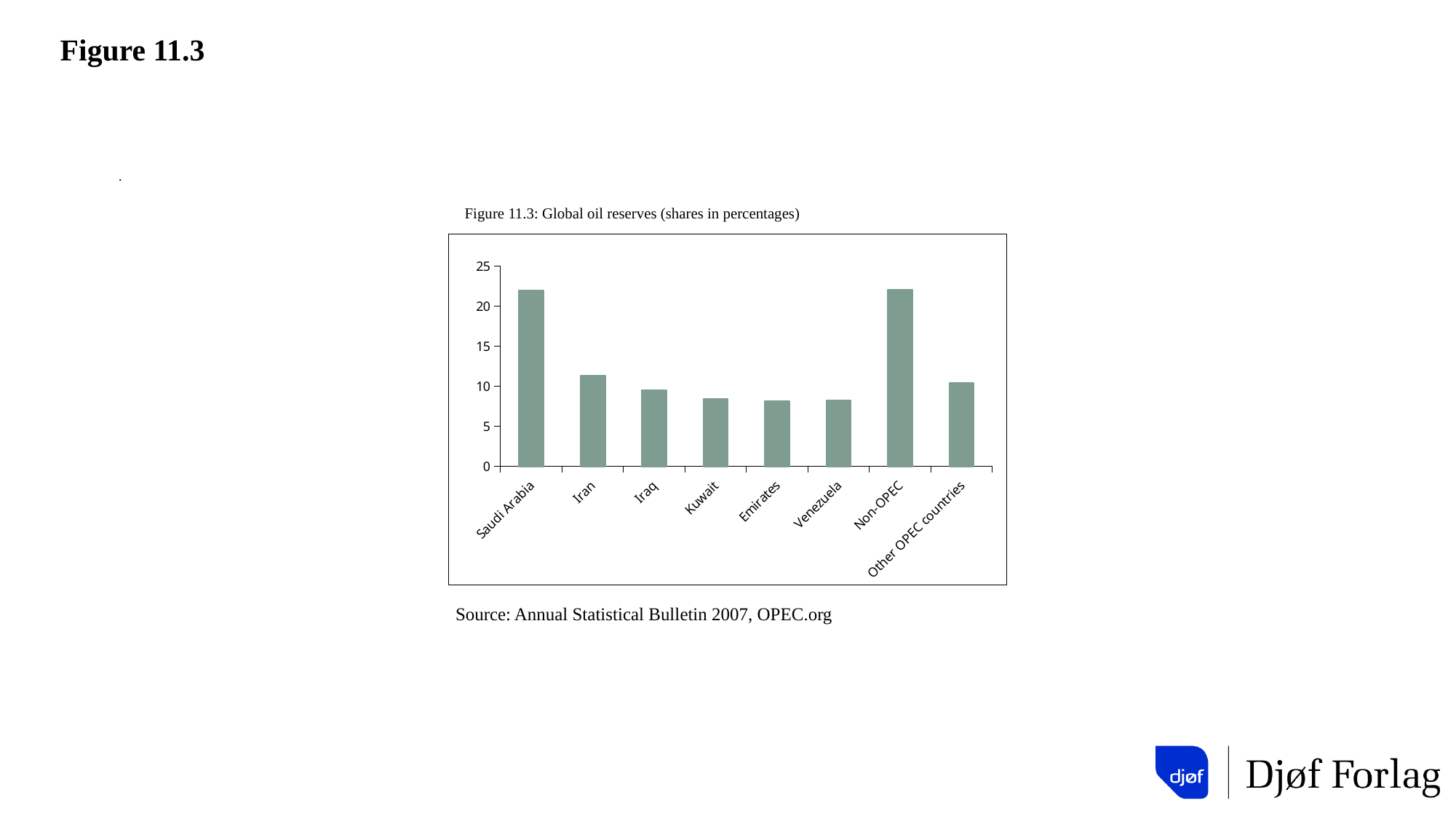
Which has the larger value, Non-OPEC or Venezuela? Non-OPEC Is the value for Iraq greater or less than 15? less What kind of chart is shown on the slide? bar chart Is the value for Iran greater or less than 10? greater How many categories are plotted on the x axis of the chart? 8 Is the value for Non-OPEC greater or less than 20? greater What is the title of the chart? Figure 11.3: Global oil reserves (shares in percentages) What source is cited below the chart? Annual Statistical Bulletin 2007, OPEC.org Which has the larger value, Saudi Arabia or Iran? Saudi Arabia